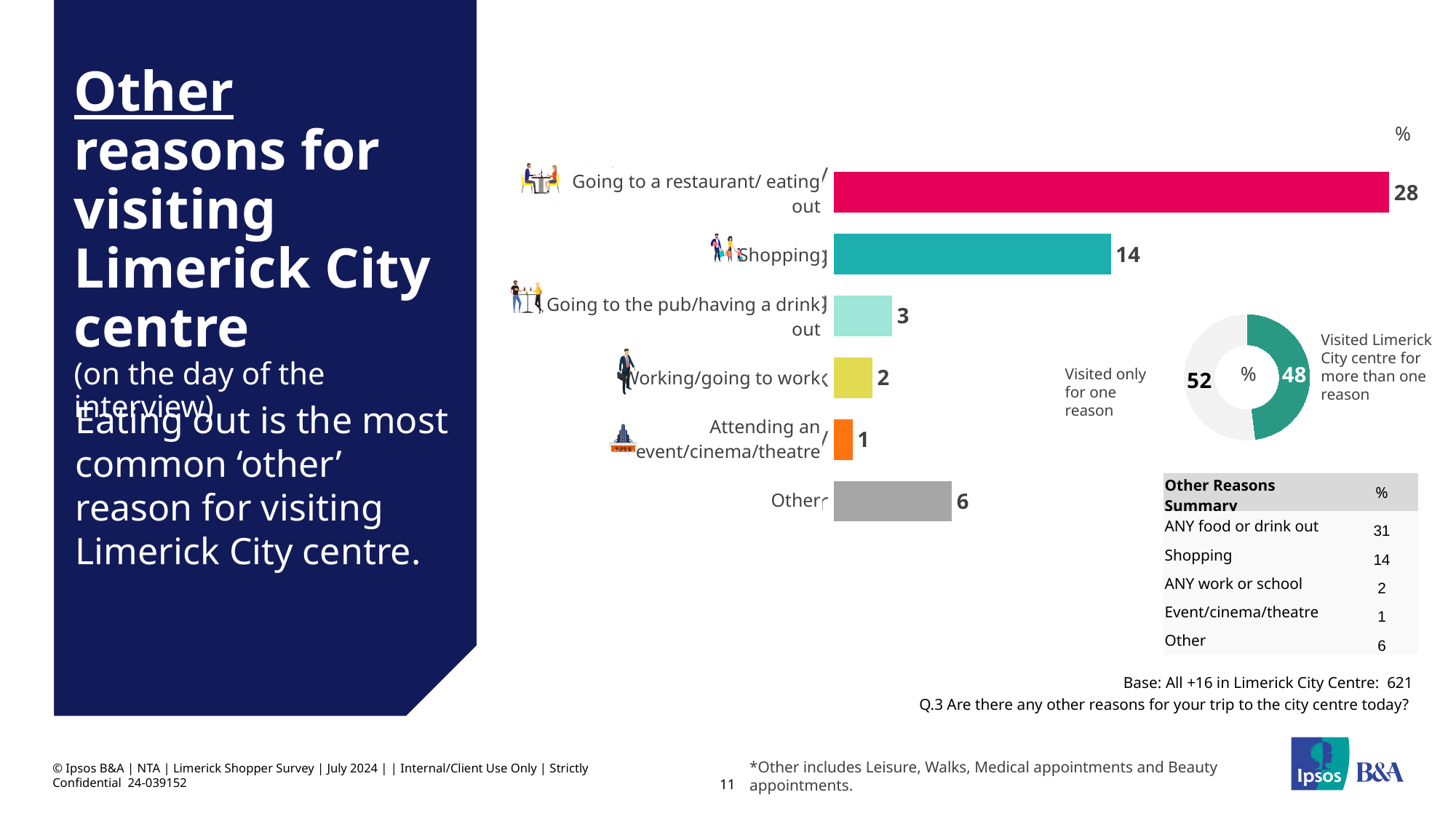
How many categories does the bar chart show? 6 In the bar chart, which category has the highest value? Going to a restaurant/ eating out In the bar chart, which category has the lowest value? Attending an event/cinema/theatre In the bar chart, what is the difference between the values for Going to a restaurant/ eating out and Shopping? 14 In the donut chart, what is the value for Visited Limerick City centre for more than one reason? 48 In the bar chart, what is the value for Attending an event/cinema/theatre? 1 In the bar chart, which is larger: the value for Other or the value for Going to the pub/having a drink out? Other In the donut chart, what is the value for Visited only for one reason? 52 In the bar chart, what is the value for Going to the pub/having a drink out? 3 In the bar chart, what is the value for Going to a restaurant/ eating out? 28 In the bar chart, what is the value for Shopping? 14 What kind of chart is the chart on the left showing reasons for visiting? Bar chart